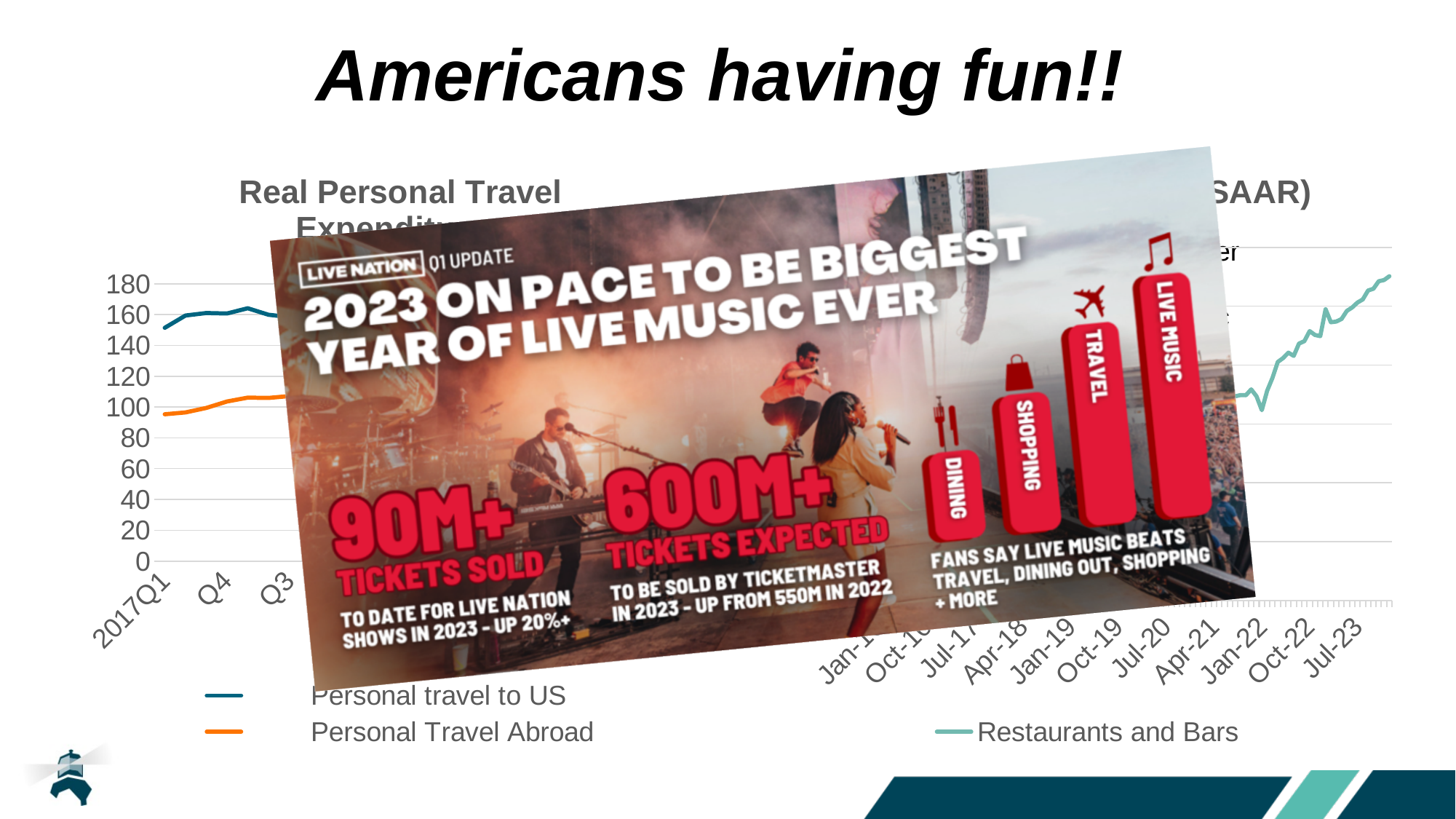
On the left chart (Real Personal Travel Expenditure), is the value for Personal Travel Abroad at 2017Q1 greater or less than 100? less On the right chart, does the Restaurants and Bars line rise or fall between Jan-22 and Jul-23? rise How many series does the legend of the left chart (Real Personal Travel Expenditure) list? 2 On the left chart (Real Personal Travel Expenditure), is the value for Personal travel to US at 2017Q1 greater or less than 140? greater What is the last x-axis label on the right chart? Jul-23 On the left chart (Real Personal Travel Expenditure), which series has the larger value at 2017Q1, Personal travel to US or Personal Travel Abroad? Personal travel to US What kind of chart is the right chart with the 'Restaurants and Bars' legend? line chart On the left chart (Real Personal Travel Expenditure), which series is shown in orange? Personal Travel Abroad How many series does the legend of the right chart list? 1 What kind of chart is the left chart titled 'Real Personal Travel Expenditure'? line chart